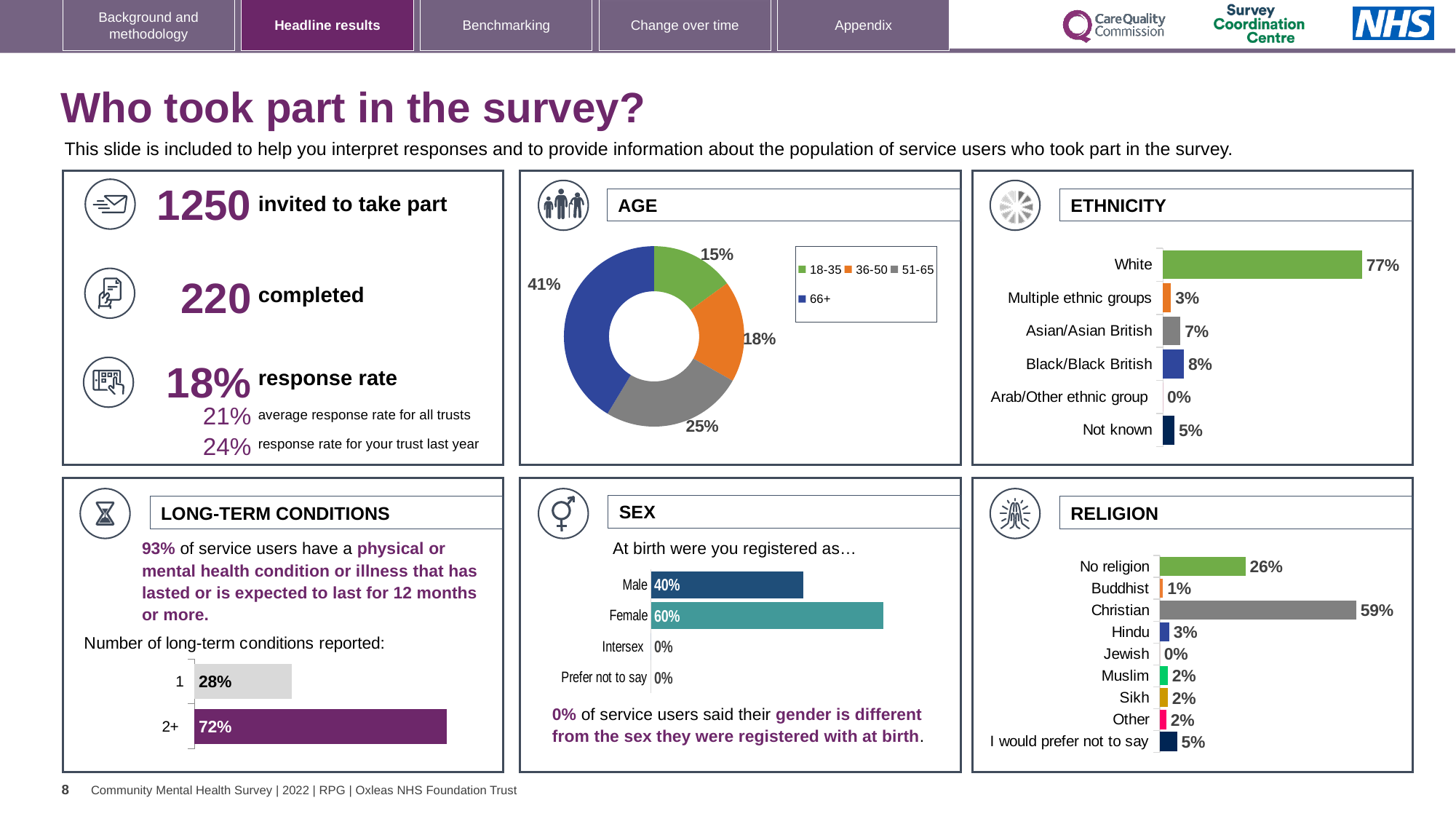
In the AGE chart, which age group has the smallest share? 18-35 In the RELIGION chart, which religion has the highest value? Christian In the LONG-TERM CONDITIONS chart, what percentage reported 2+ conditions? 72% In the ETHNICITY chart, what is the difference between White and Black/Black British? 69% In the ETHNICITY chart, what is the value for Asian/Asian British? 7% In the RELIGION chart, which is larger, No religion or Muslim? No religion In the ETHNICITY chart, which category has the highest value? White In the SEX chart, what is the value for Female? 60% How many age groups does the legend of the AGE chart list? 4 In the AGE chart, what percentage of respondents are aged 66+? 41% What kind of chart is the AGE chart? Doughnut chart In the SEX chart, how many categories are shown? 4